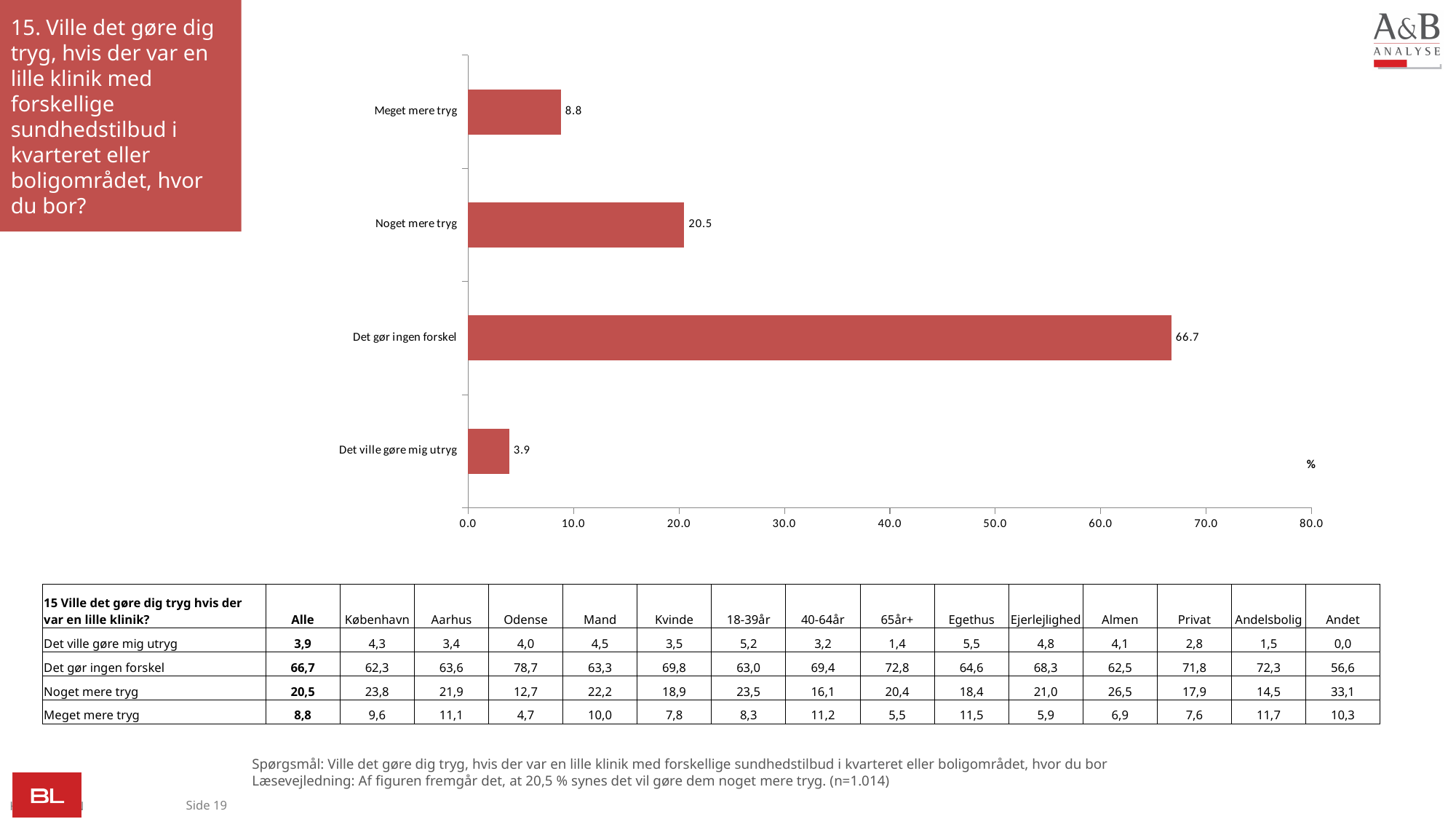
How many categories are shown in the chart? 4 What is the difference between the values for "Noget mere tryg" and "Meget mere tryg"? 11.7 What value is shown for "Noget mere tryg" in the chart? 20.5 Which is larger: the value for "Meget mere tryg" or the value for "Det ville gøre mig utryg"? Meget mere tryg What is the maximum value shown on the horizontal axis of the chart? 80.0 Is the value for "Det gør ingen forskel" greater or less than 60.0? greater What type of chart is shown on the slide? Bar chart Which category has the lowest value in the chart? Det ville gøre mig utryg What value is shown for "Det ville gøre mig utryg" in the chart? 3.9 What value is shown for "Meget mere tryg" in the chart? 8.8 Which category has the highest value in the chart? Det gør ingen forskel What value is shown for "Det gør ingen forskel" in the chart? 66.7